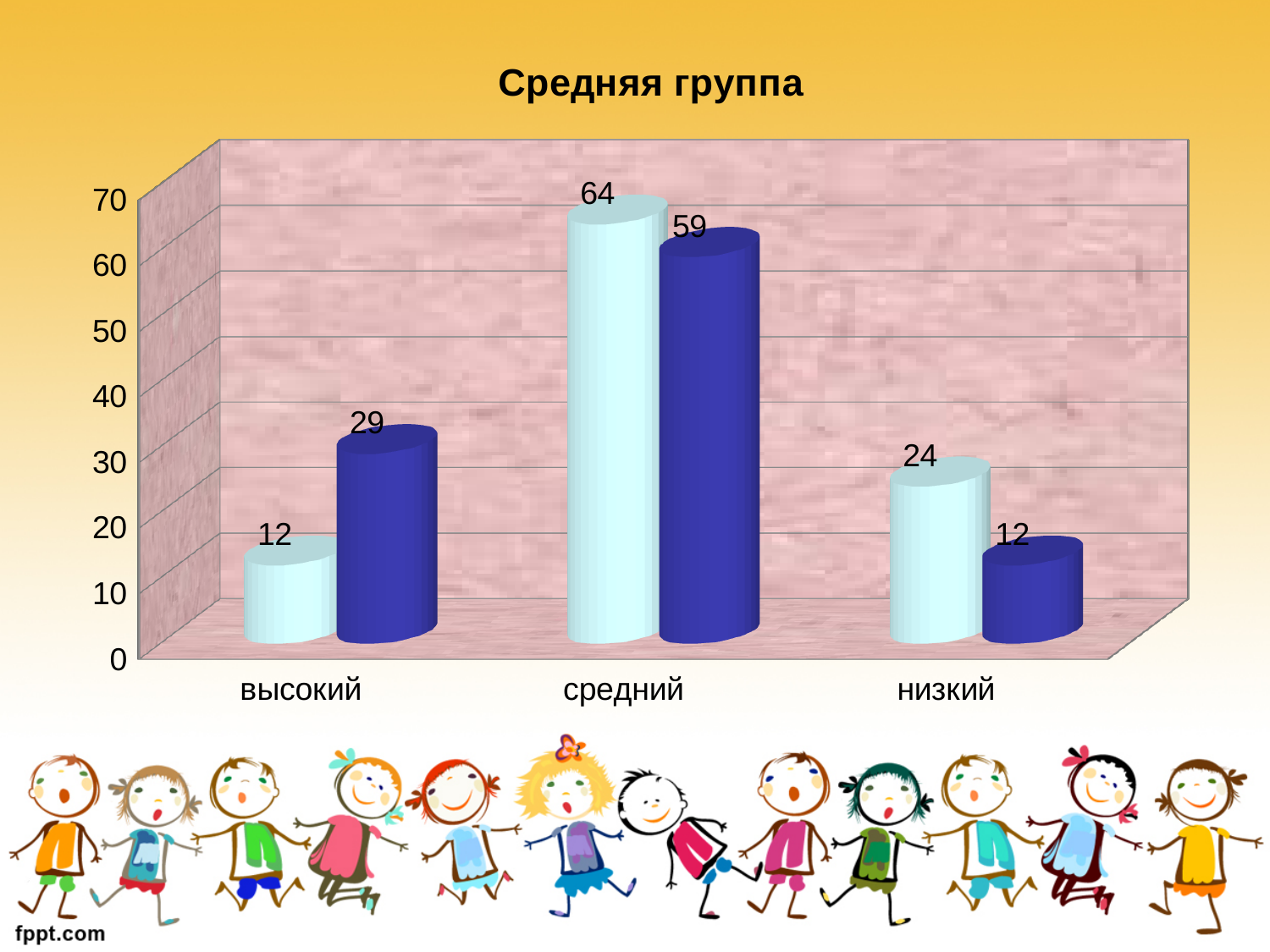
Which category has the lowest dark blue bar? низкий For высокий, which bar is larger, the light blue or the dark blue? dark blue How many categories are shown on the x axis? 3 What kind of chart is shown on the slide? bar chart What is the value of the dark blue bar for высокий? 29 What is the difference between the dark blue bars for высокий and низкий? 17 What is the value of the light blue bar for низкий? 24 What is the title of the chart? Средняя группа What is the value of the dark blue bar for низкий? 12 What is the value of the light blue bar for средний? 64 Which category has the highest light blue bar? средний What is the difference between the light blue and dark blue bars for средний? 5